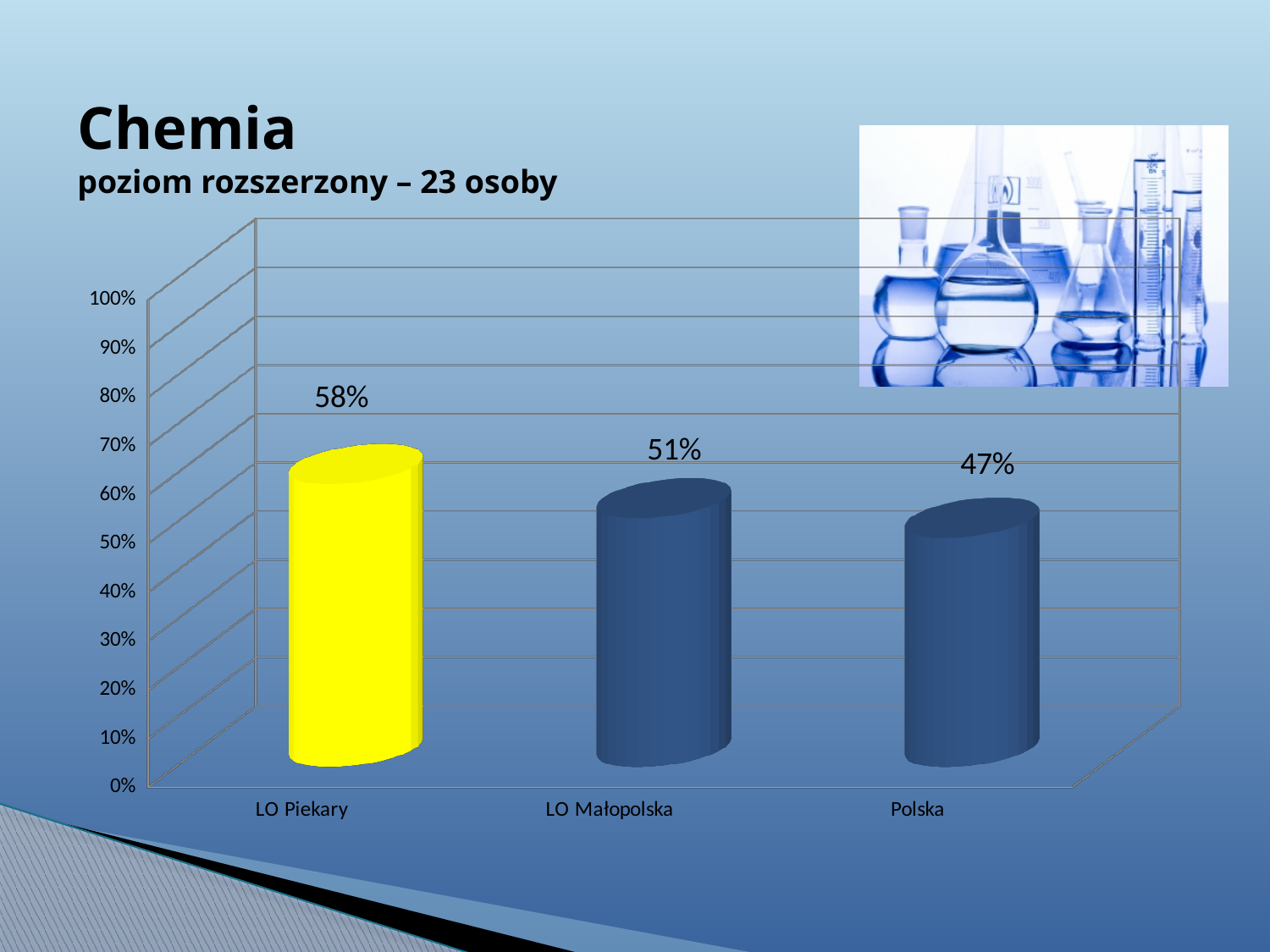
What is the difference between the values for LO Piekary and LO Małopolska? 7% What is the value for LO Piekary? 58% What kind of chart is shown on the slide? bar chart Which category has the highest value? LO Piekary Is the value for Polska greater or less than 50%? less How many categories are shown on the chart? 3 Which category has the lowest value? Polska Do the values rise or fall from left to right along the x axis? fall What is the value for LO Małopolska? 51% What is the difference between the values for LO Piekary and Polska? 11% Which is larger, the value for LO Małopolska or the value for Polska? LO Małopolska What is the value for Polska? 47%